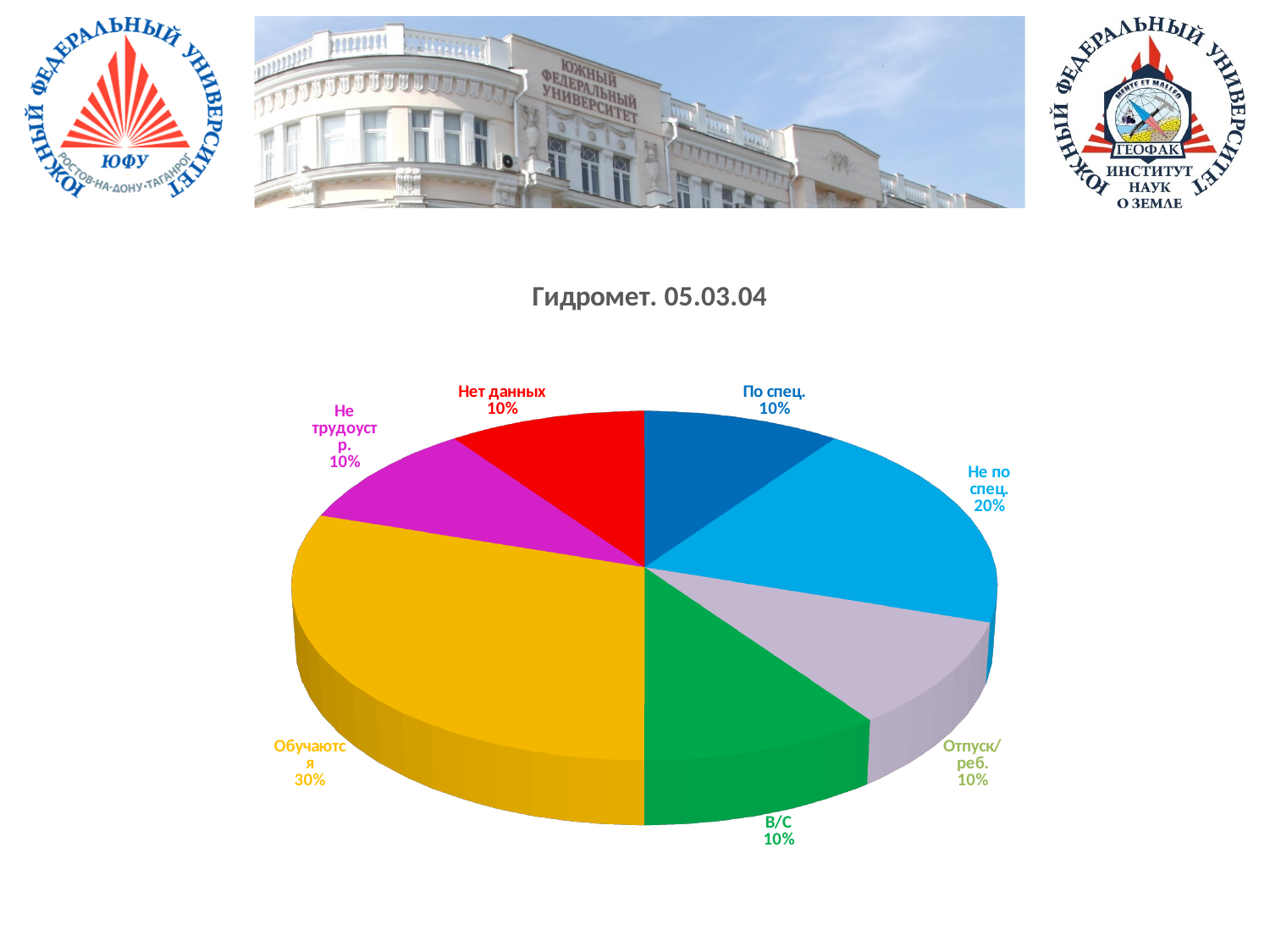
What is the value shown for "По спец."? 10% How many slices does the pie chart have? 7 What is the value shown for "Отпуск/реб."? 10% What share of the pie is labelled "Обучаются"? 30% What is the difference between the shares of "Обучаются" and "Не по спец."? 10% Which category has the largest slice of the pie? Обучаются What is the value shown for "Нет данных"? 10% What is the title of the chart? Гидромет. 05.03.04 What share of the pie is labelled "Не по спец."? 20% What colour is the "Обучаются" slice? yellow Which is larger, the share for "Не по спец." or the share for "В/С"? Не по спец. What kind of chart is shown on the slide? pie chart